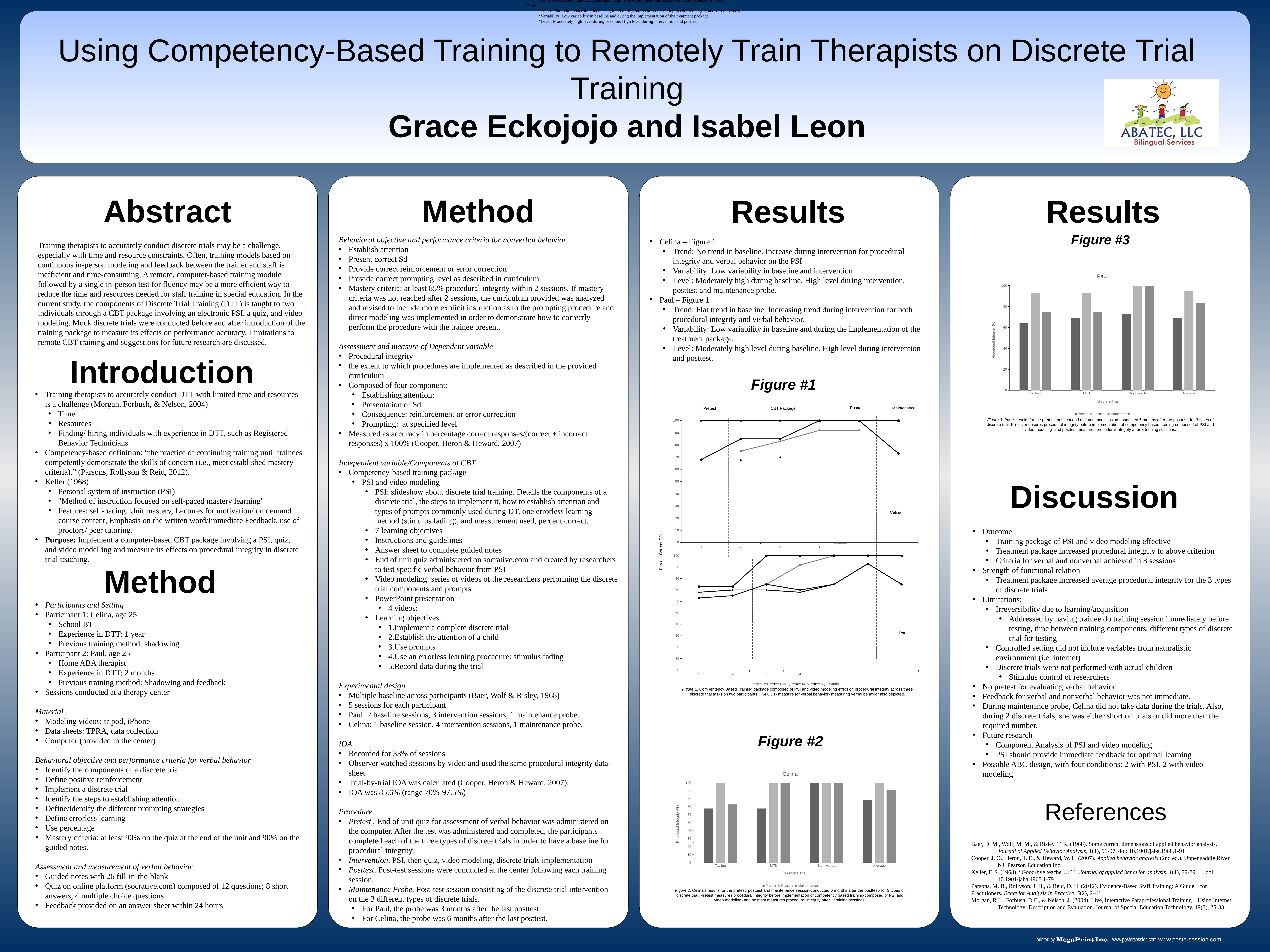
In Figure #2, is the Pretest value for Tacting greater or less than 80? less How many series does the legend of Figure #1 list? 4 In Figure #2, which is larger for Tacting: the Pretest value or the Posttest value? Posttest How many series does the legend of Figure #2 list? 3 In Figure #2, is the Maintenance value for Average greater or less than 80? greater What kind of chart is Figure #2? bar chart What is the y-axis label of Figure #1? Percent Correct (%) In Figure #3, which is larger for Tacting: the Posttest value or the Maintenance value? Posttest How many discrete trial categories are shown on the x axis of Figure #2? 4 How many series does the legend of Figure #3 list? 3 What kind of chart is Figure #3? bar chart In Figure #3, is the Posttest value for Sight words greater or less than 80? greater